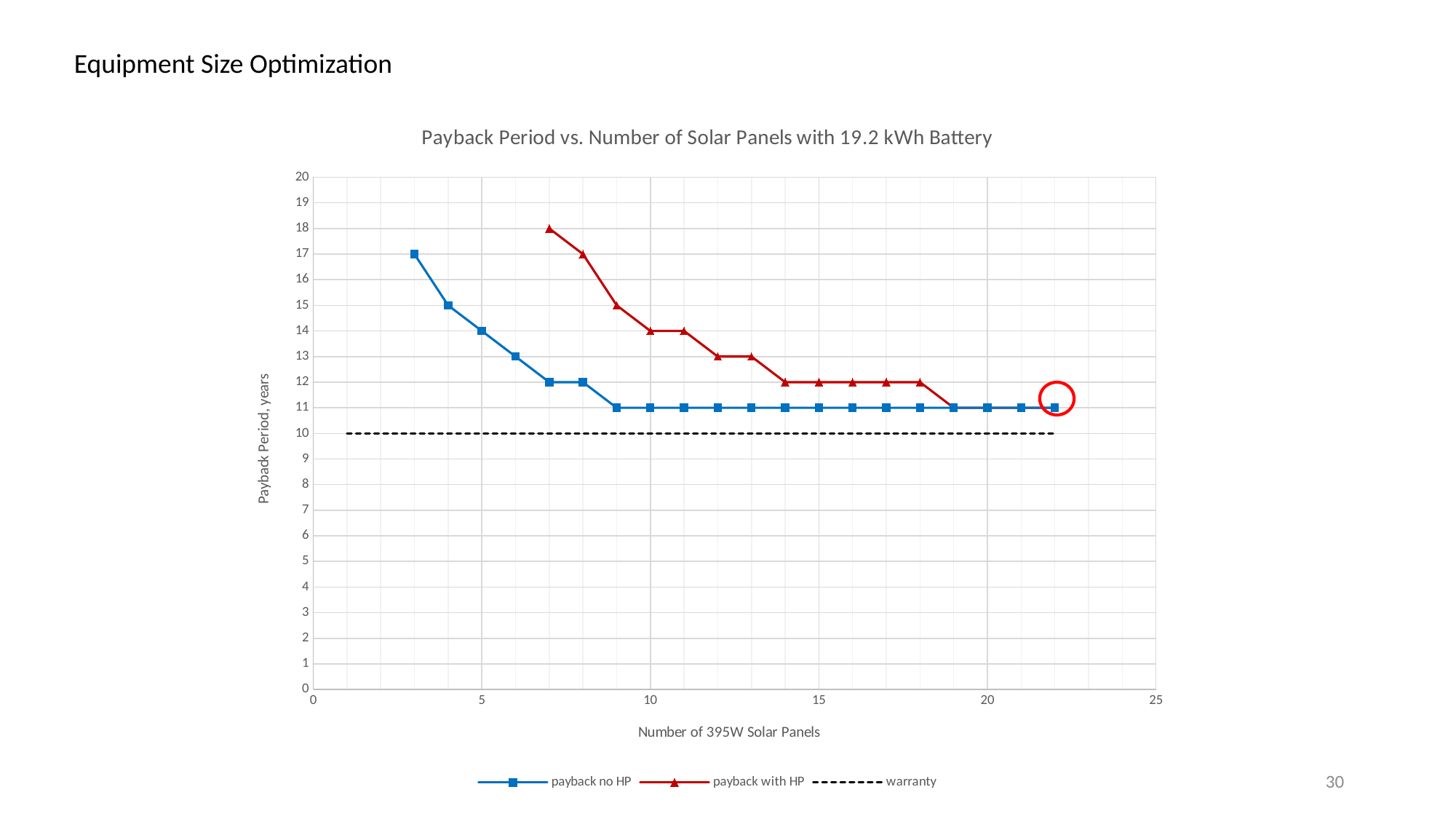
What type of chart is shown on the slide? line chart What is the payback period for 'payback with HP' at 10 solar panels? 14 What is the difference between 'payback with HP' and 'payback no HP' at 8 solar panels? 5 What is the title of the chart? Payback Period vs. Number of Solar Panels with 19.2 kWh Battery What is the payback period for 'payback no HP' at 3 solar panels? 17 What is the lowest payback period reached by the 'payback with HP' series? 11 Is the 'payback no HP' value at 22 solar panels greater or less than 10? greater How many series does the legend list? 3 At 12 solar panels, which series has the larger payback period, 'payback no HP' or 'payback with HP'? payback with HP Does the 'payback no HP' series rise or fall as the number of solar panels increases? fall What value does the 'warranty' dashed line sit at? 10 What is the payback period for 'payback with HP' at 7 solar panels? 18